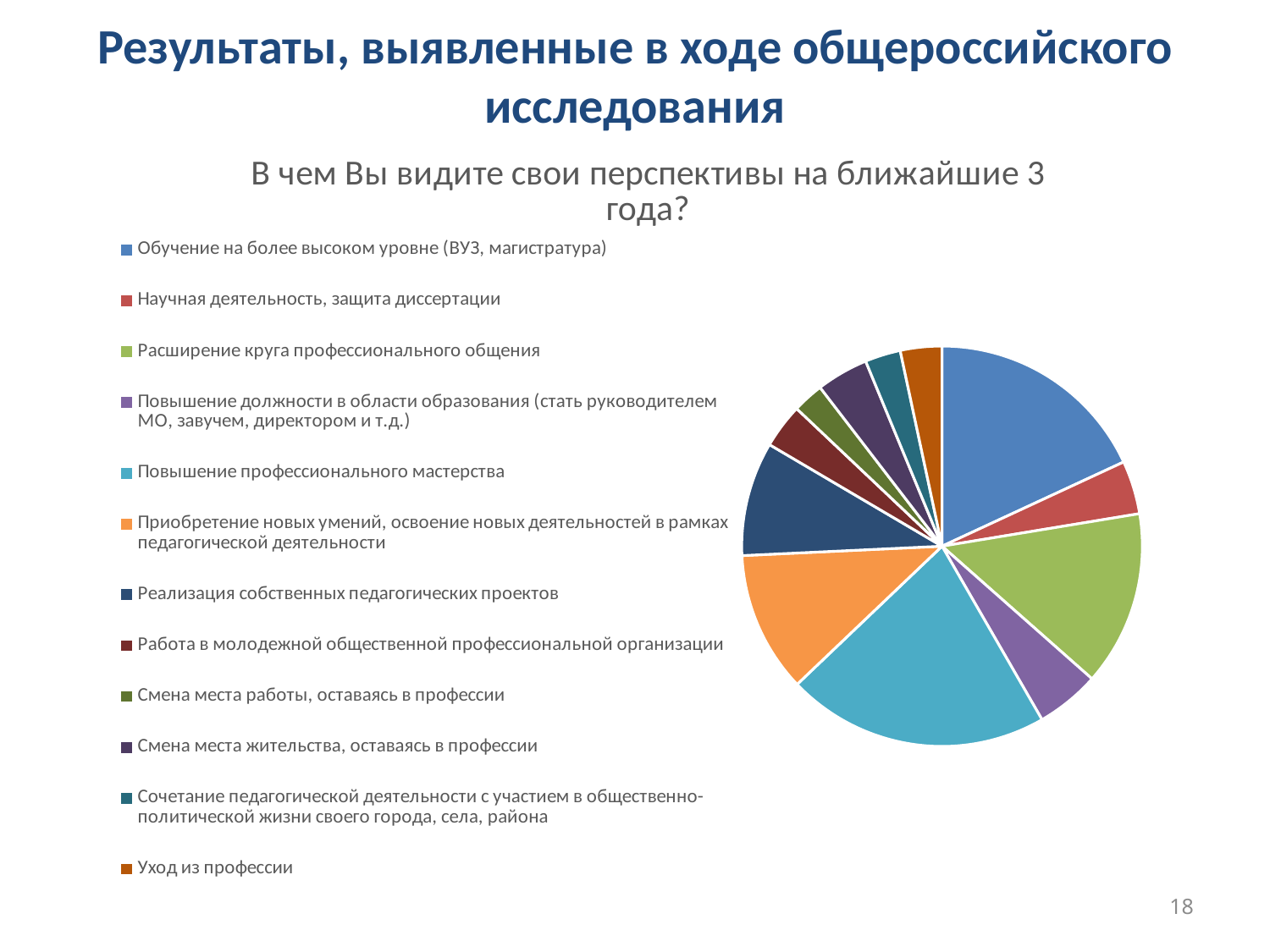
Which slice is larger: "Обучение на более высоком уровне (ВУЗ, магистратура)" or "Научная деятельность, защита диссертации"? Обучение на более высоком уровне (ВУЗ, магистратура) Which category has the largest slice in the pie chart? Повышение профессионального мастерства Which legend entry is listed last in the pie chart's legend? Уход из профессии What kind of chart is shown on the slide? pie chart What is the title of the pie chart? В чем Вы видите свои перспективы на ближайшие 3 года? Which slice is larger: "Расширение круга профессионального общения" or "Уход из профессии"? Расширение круга профессионального общения Which slice is larger: "Приобретение новых умений, освоение новых деятельностей в рамках педагогической деятельности" or "Смена места жительства, оставаясь в профессии"? Приобретение новых умений, освоение новых деятельностей в рамках педагогической деятельности How many categories (slices) does the pie chart have? 12